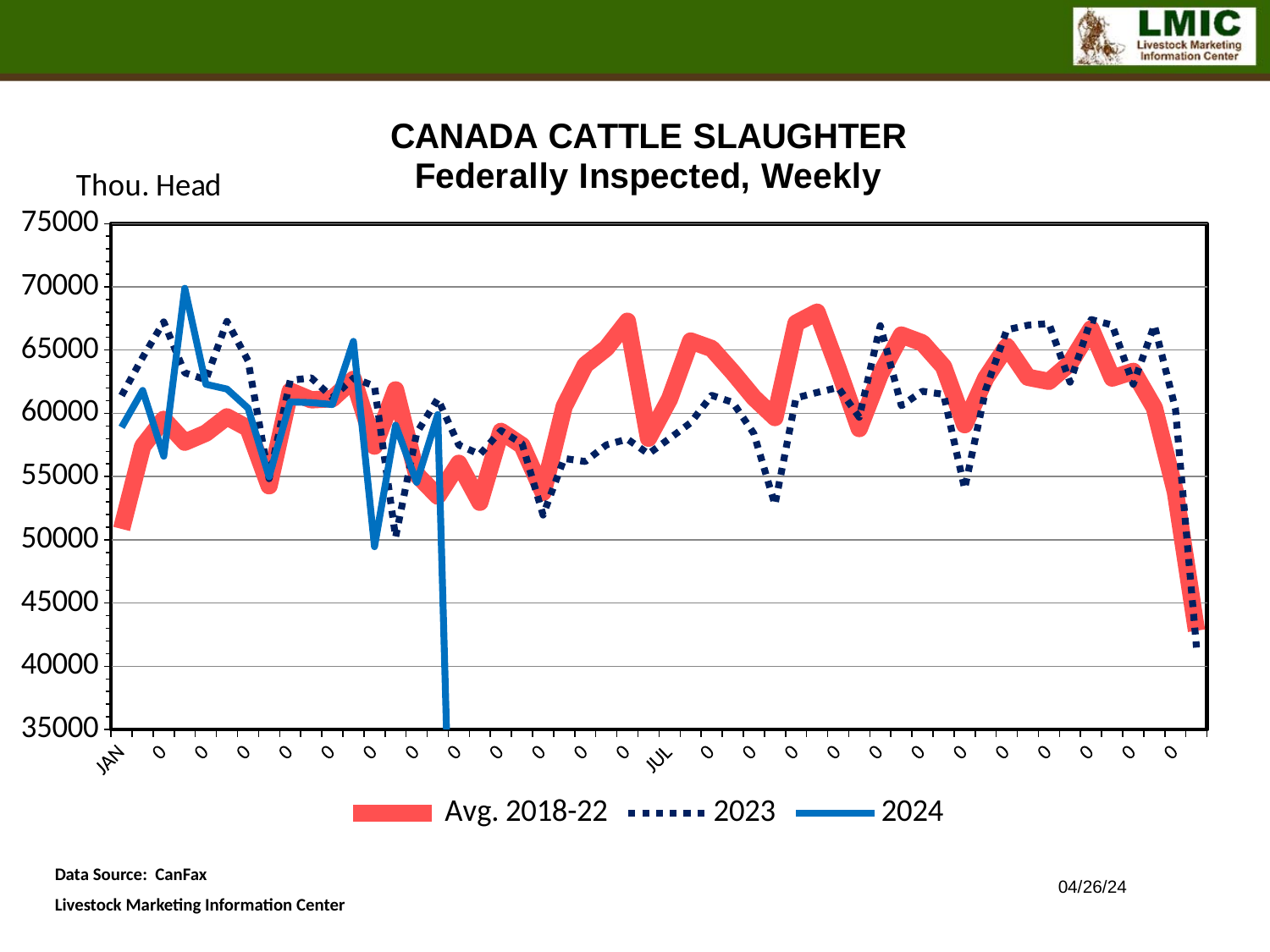
Is the peak value of the 2024 line near the start of the year greater or less than 65000? greater What kind of chart is shown on the slide? line chart What are the three series listed in the legend? Avg. 2018-22, 2023, 2024 Is the final value of the 2023 line at the end of the year greater or less than 45000? less How many series does the legend list? 3 Is the final value of the Avg. 2018-22 line at the end of the year greater or less than 45000? less Which series reaches the highest value anywhere on the chart? 2024 What unit label is shown above the y axis? Thou. Head Does the Avg. 2018-22 line rise or fall over the last few weeks of the year? fall At JAN, which is larger: the 2024 value or the Avg. 2018-22 value? 2024